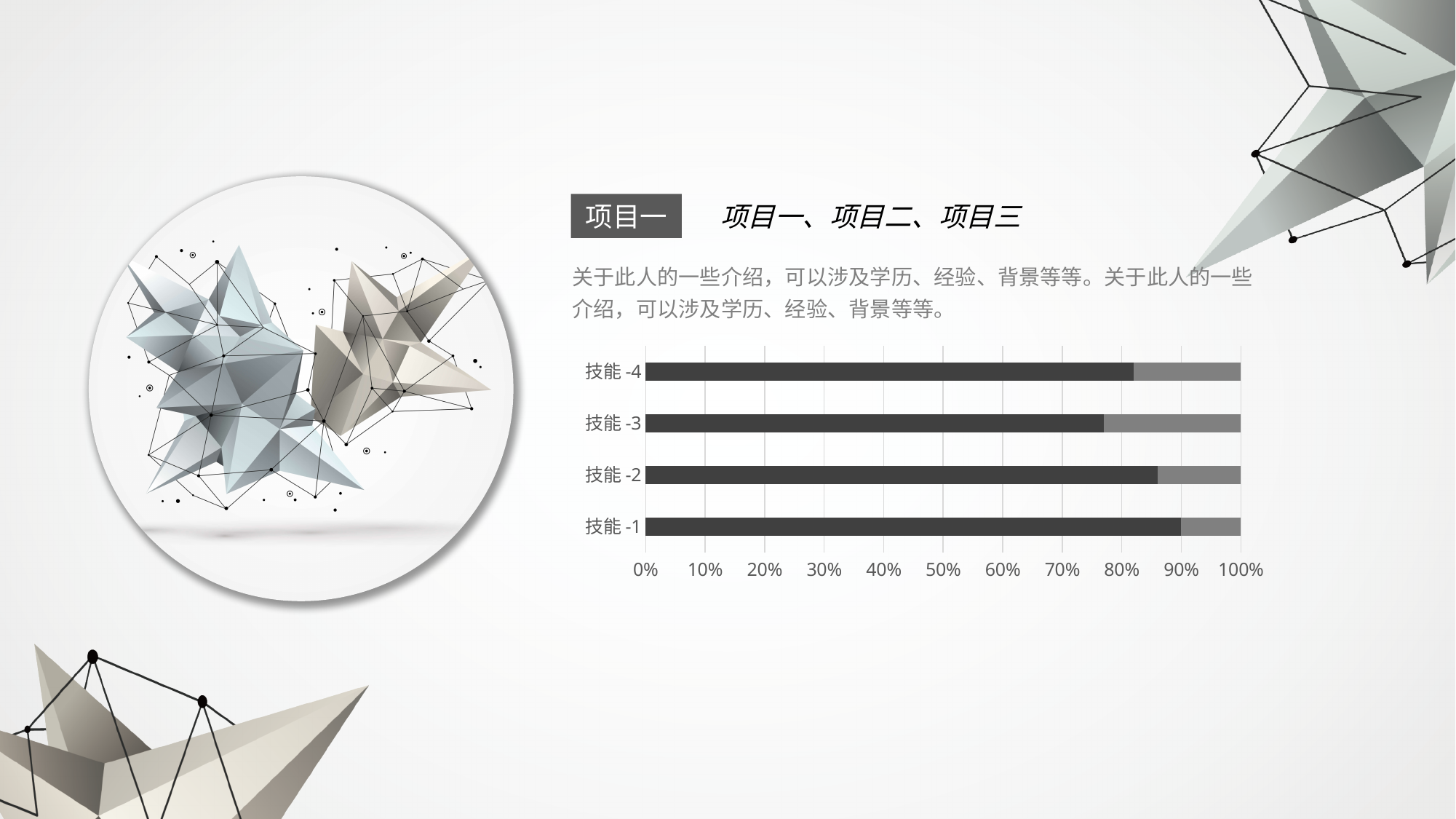
What is the highest value labelled on the horizontal axis of the chart? 100% Is the dark segment for 技能 -3 greater or less than 70%? greater What is the total length of the full stacked bar for 技能 -1 (dark plus light segments)? 100% How many categories (skills) are plotted in the bar chart? 4 Which skill has the longest dark bar segment? 技能 -1 Is the dark segment for 技能 -2 greater or less than 80%? greater Is the dark segment for 技能 -3 greater or less than 80%? less Which skill has the shortest dark bar segment? 技能 -3 What kind of chart is shown on the slide? bar chart Which has the larger dark segment, 技能 -1 or 技能 -3? 技能 -1 Which has the larger dark segment, 技能 -2 or 技能 -4? 技能 -2